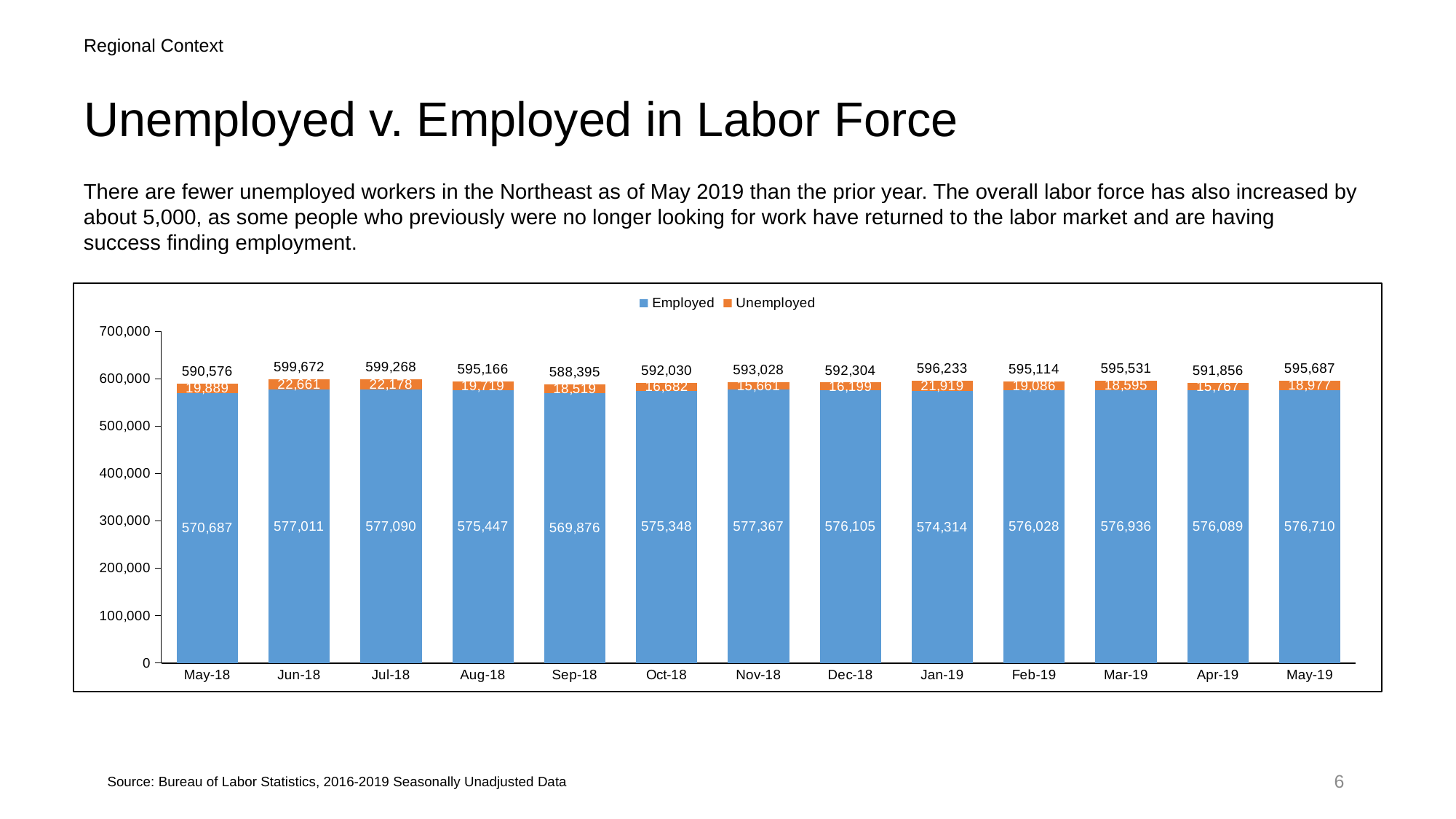
Which month has the lowest Unemployed value? Nov-18 Which month has the highest Unemployed value? Jun-18 Which month has the lowest Employed value? Sep-18 How many months are shown on the x axis? 13 Which colour represents the Unemployed series? Orange What is the difference between the Unemployed value in May-18 and in May-19? 912 What is the total labor force (stacked bar total) for May-19? 595,687 What is the Unemployed value for Jan-19? 21,919 What is the Employed value for Sep-18? 569,876 What type of chart is shown? Stacked bar chart Which is larger, the Unemployed value for Jul-18 or for Apr-19? Jul-18 How many series does the legend list? 2